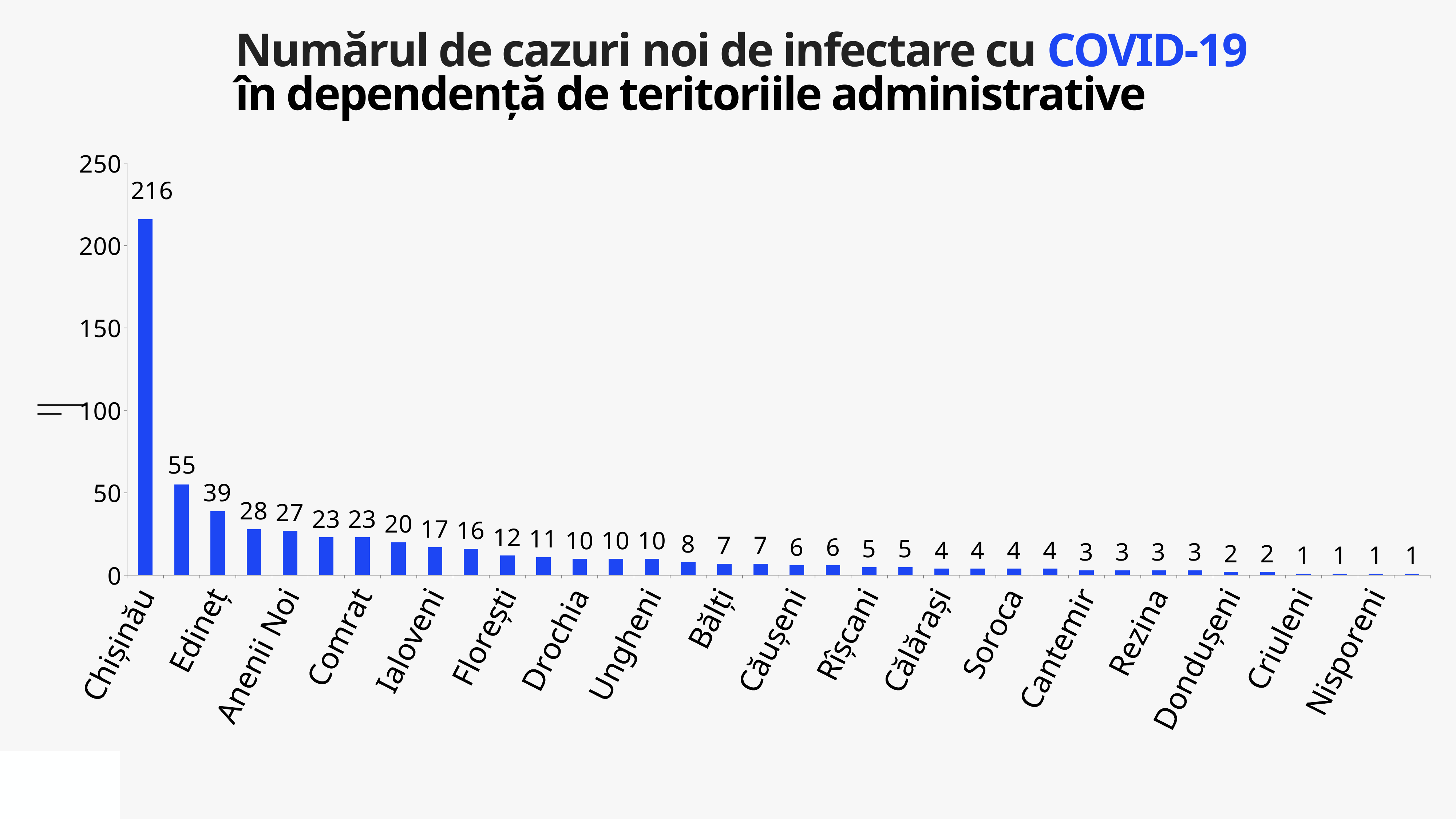
Do the values rise or fall moving from left to right along the x axis? Fall What kind of chart is shown on the slide? Bar chart Which has more new cases, Chișinău or Edineț? Chișinău What is the value for Chișinău? 216 What is the highest tick value shown on the y axis? 250 What is the smallest value shown on any bar in the chart? 1 Is the value for Nisporeni greater or less than 50? less Is the value for Chișinău greater or less than 200? greater Which category has the highest number of new cases? Chișinău What is the difference between the tallest bar (216) and the second-tallest bar (55)? 161 How many bars are plotted in the chart? 36 What colour are the bars in the chart? Blue